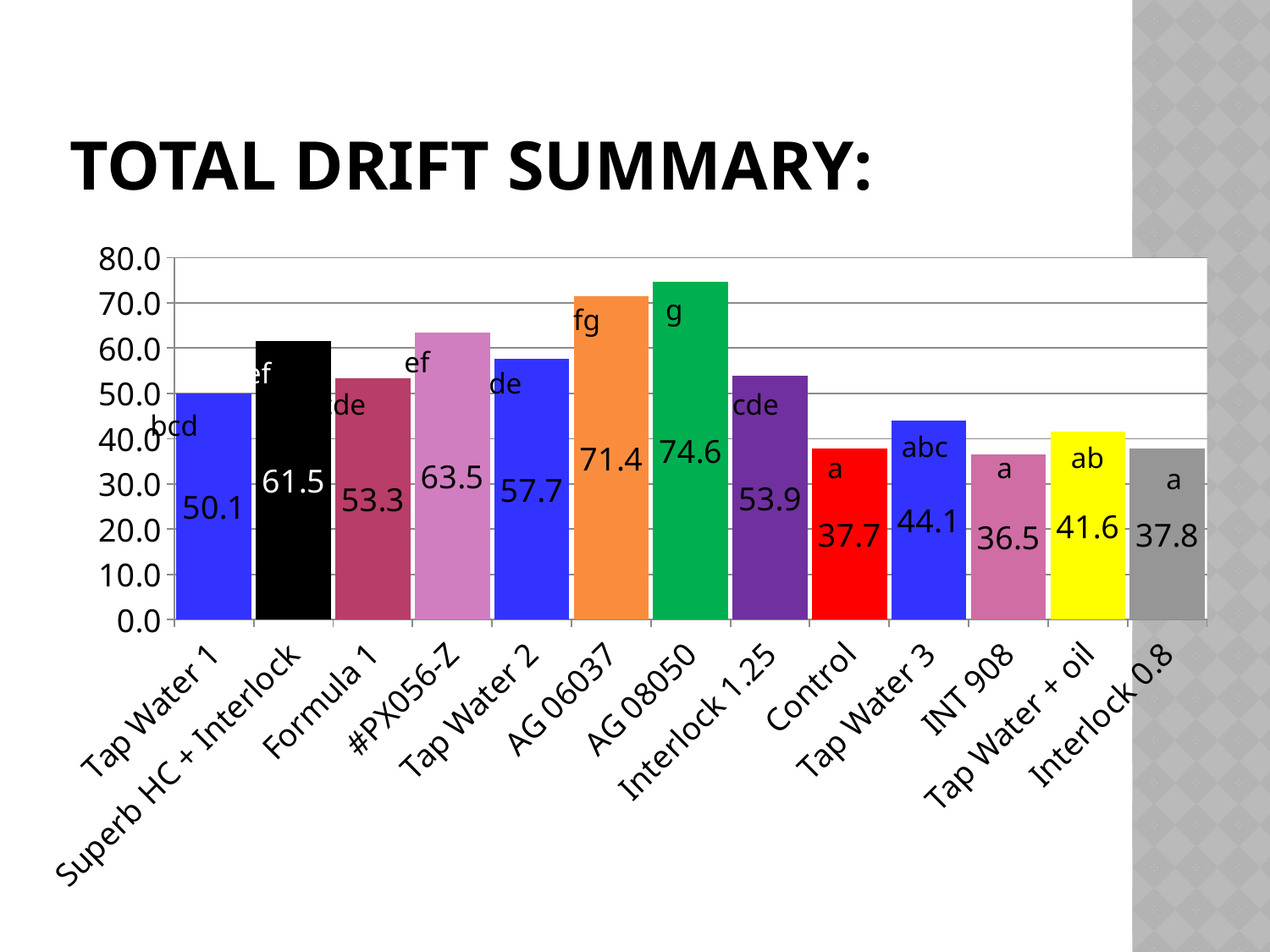
What is the value for INT 908? 36.5 What letter label is printed on the bar for AG 08050? g Which category has the highest value? AG 08050 What is the difference between the values for Superb HC + Interlock and Tap Water 1? 11.4 What is the value for AG 08050? 74.6 What kind of chart is shown on the slide? Bar chart What is the difference between the values for AG 08050 and AG 06037? 3.2 How many categories are shown on the x axis? 13 Which is larger, the value for #PX056-Z or the value for Tap Water 2? #PX056-Z What is the value for Tap Water + oil? 41.6 What is the value for Superb HC + Interlock? 61.5 Which category has the lowest value? INT 908